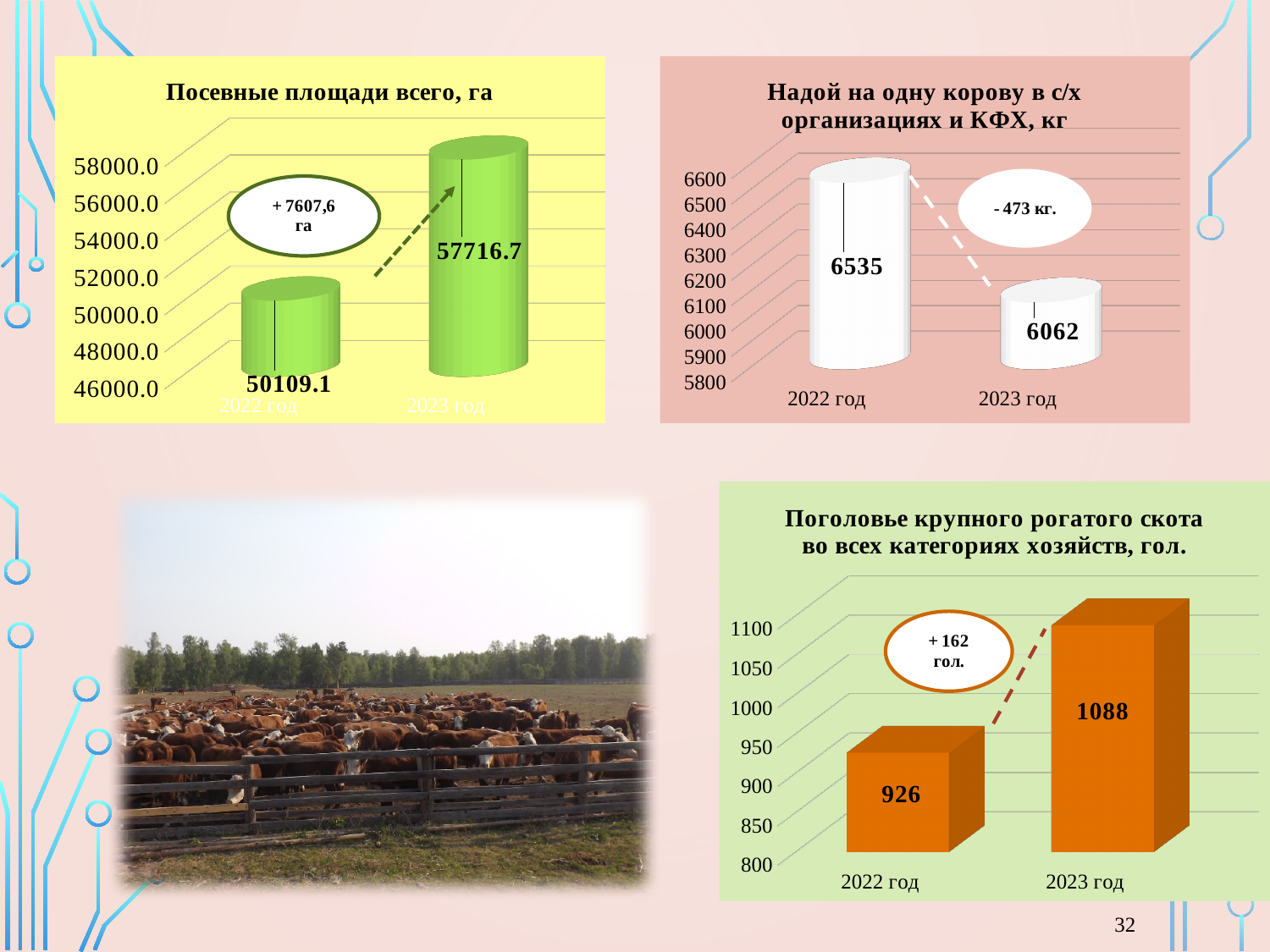
In the chart 'Надой на одну корову в с/х организациях и КФХ, кг', what is the difference between the 2022 and 2023 values? 473 How many categories are shown in the chart 'Посевные площади всего, га'? 2 In the chart 'Надой на одну корову в с/х организациях и КФХ, кг', what is the value for 2022 год? 6535 In the chart 'Поголовье крупного рогатого скота во всех категориях хозяйств, гол.', do the values rise or fall from 2022 год to 2023 год? rise In the chart 'Посевные площади всего, га', what is the value for 2023 год? 57716.7 In the chart 'Поголовье крупного рогатого скота во всех категориях хозяйств, гол.', what is the value for 2023 год? 1088 What kind of chart is 'Поголовье крупного рогатого скота во всех категориях хозяйств, гол.'? bar chart In the chart 'Поголовье крупного рогатого скота во всех категориях хозяйств, гол.', what is the value for 2022 год? 926 In the chart 'Посевные площади всего, га', by how much did the value change from 2022 год to 2023 год? 7607.6 In the chart 'Надой на одну корову в с/х организациях и КФХ, кг', what is the value for 2023 год? 6062 In the chart 'Посевные площади всего, га', what is the value for 2022 год? 50109.1 In the chart 'Надой на одну корову в с/х организациях и КФХ, кг', which year has the lower value? 2023 год